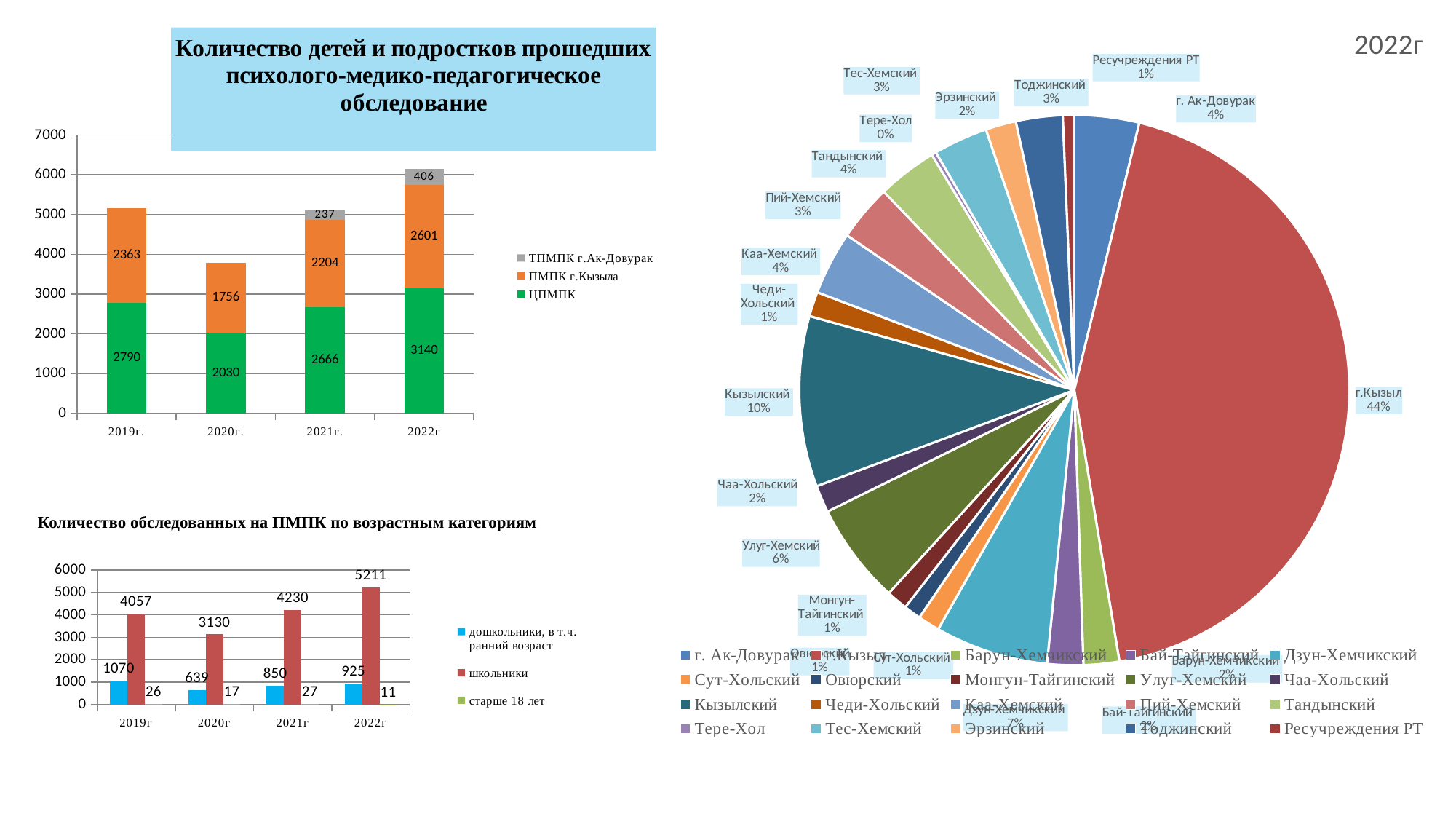
How many series does the legend of the top-left stacked bar chart list? 3 In the bottom-left chart, which year has the lowest value for старше 18 лет? 2022г What kind of chart is the chart on the right side of the slide? pie chart In the bottom-left chart 'Количество обследованных на ПМПК по возрастным категориям', what is the value for школьники in 2022г? 5211 In the top-left stacked bar chart, what is the difference between the ЦПМПК values for 2022г and 2021г.? 474 In the top-left chart 'Количество детей и подростков прошедших психолого-медико-педагогическое обследование', what is the value for ЦПМПК in 2022г? 3140 In the bottom-left chart, which year has the highest value for школьники? 2022г In the pie chart on the right, what share does г.Кызыл have? 44% In the pie chart on the right, what is the percentage shown for Кызылский? 10% In the bottom-left chart, what is the difference between the дошкольники values for 2019г and 2020г? 431 In the top-left stacked bar chart, what is the value for ПМПК г.Кызыла in 2020г.? 1756 In the top-left stacked bar chart, what is the total of the 2022г bar? 6147